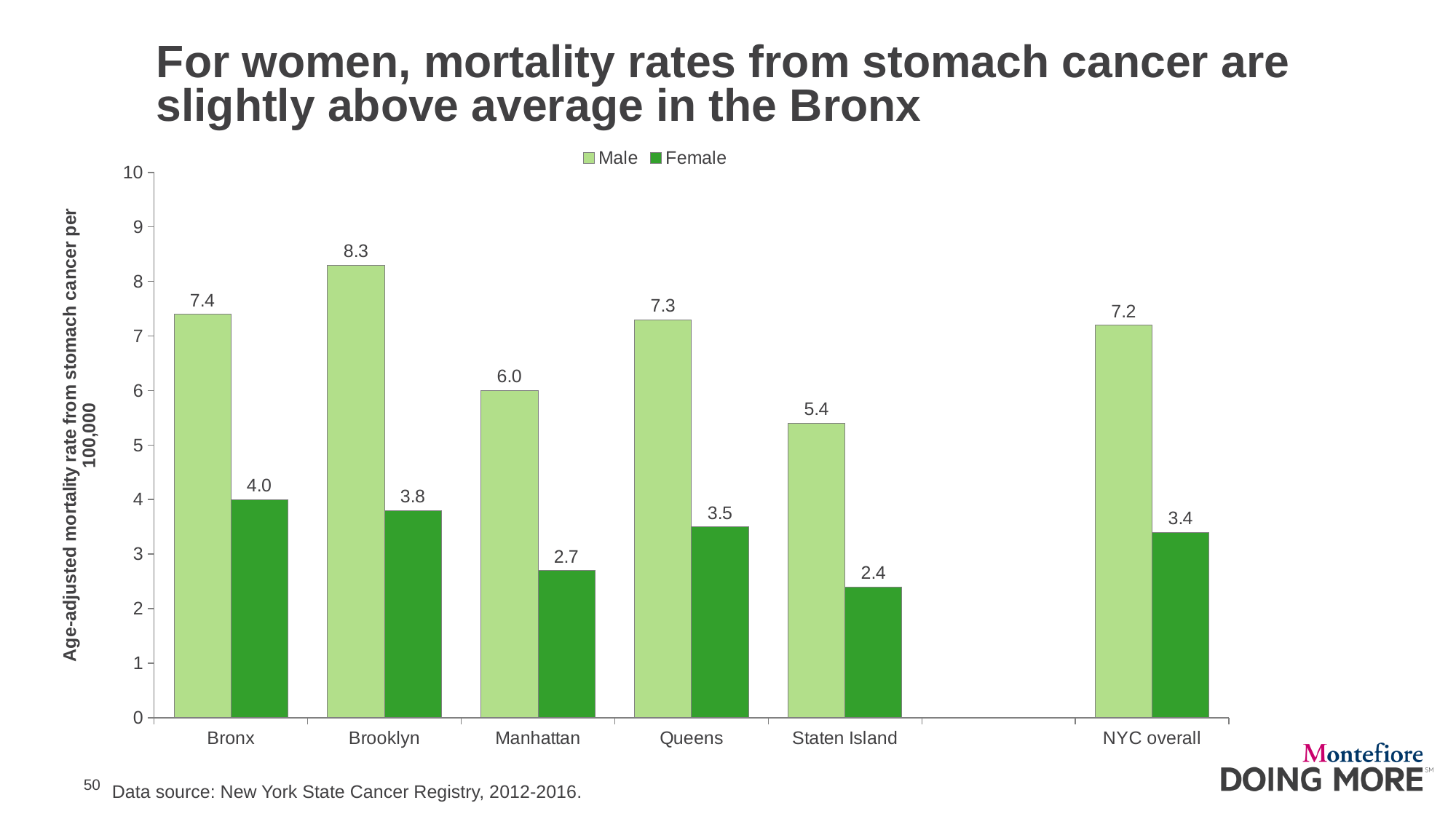
Which category has the lowest Female mortality rate? Staten Island How many categories are shown on the x axis? 6 What is the difference between the Female mortality rate in the Bronx and NYC overall? 0.6 Which category has the highest Male mortality rate? Brooklyn What is the Female mortality rate for the Bronx? 4.0 What is the Female mortality rate for NYC overall? 3.4 Is the Male mortality rate for Staten Island greater or less than 6? less What is the Male mortality rate for Brooklyn? 8.3 What is the difference between the Male and Female mortality rates in Queens? 3.8 How many series does the legend list? 2 Which is larger, the Male mortality rate in Manhattan or in Staten Island? Manhattan What kind of chart is shown on the slide? Bar chart